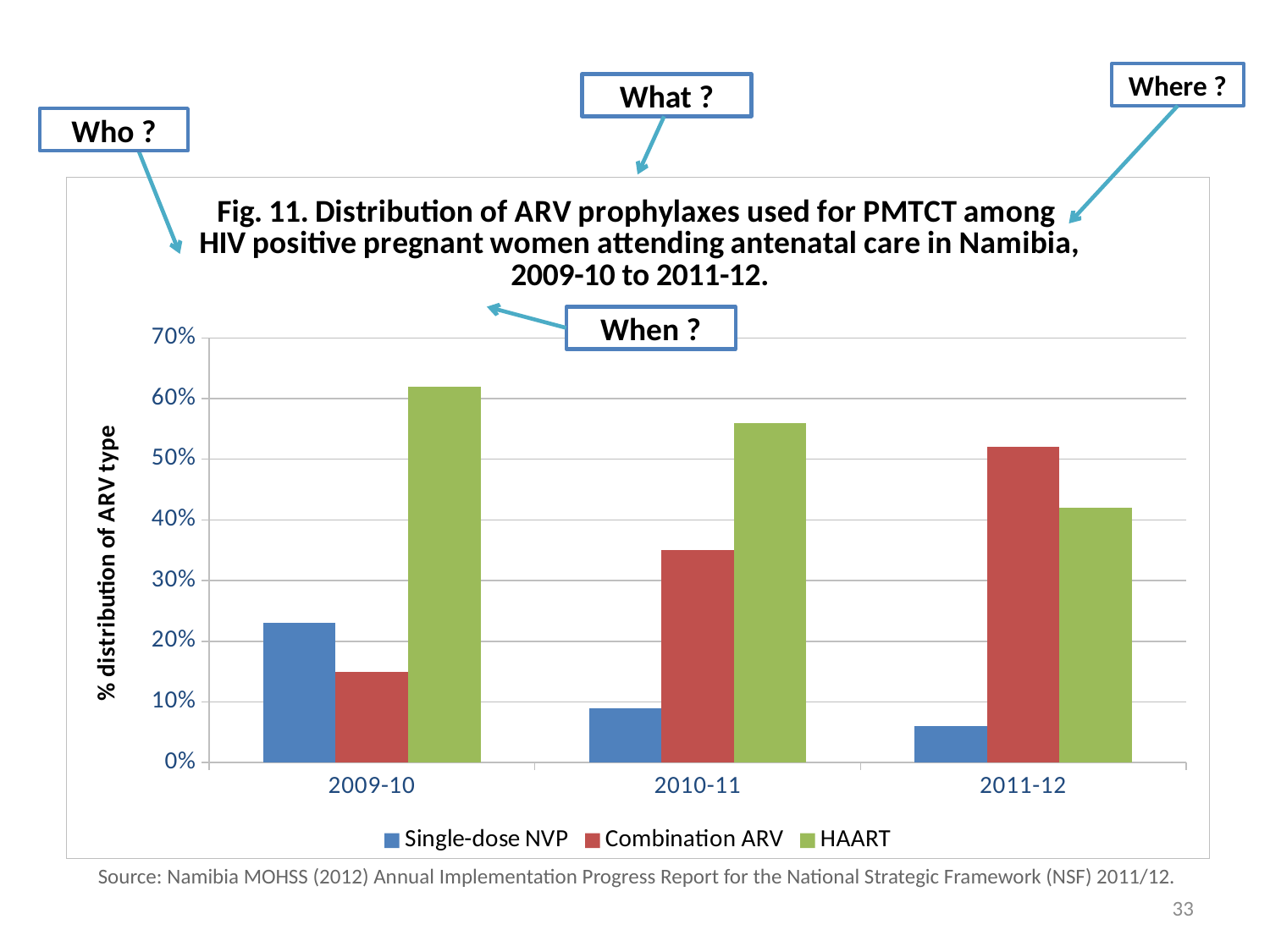
Is the value for Single-dose NVP in 2011-12 greater or less than 10%? less In 2011-12, which is larger: Combination ARV or HAART? Combination ARV What is the title of the y axis? % distribution of ARV type How many series does the legend list? 3 Does the value for Combination ARV rise or fall from 2009-10 to 2011-12? rise Is the value for HAART in 2009-10 greater or less than 50%? greater Does the value for Single-dose NVP rise or fall from 2009-10 to 2011-12? fall In which year is the HAART value highest? 2009-10 In which year is the Single-dose NVP value lowest? 2011-12 What kind of chart is shown on the slide? bar chart Is the value for Combination ARV in 2010-11 greater or less than 30%? greater How many year categories are shown on the x axis? 3